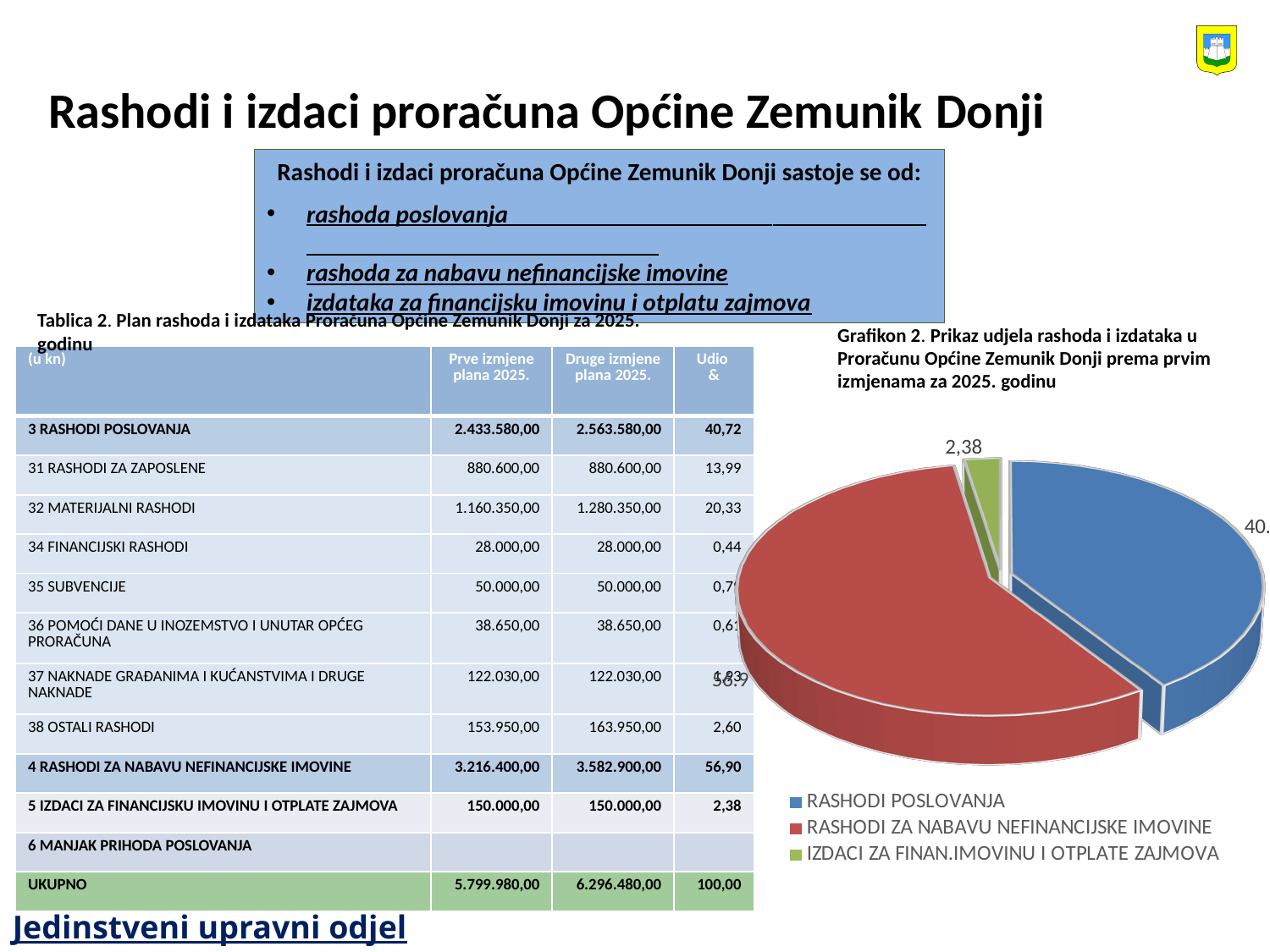
What is the title of the pie chart on the slide? Grafikon 2. Prikaz udjela rashoda i izdataka u Proračunu Općine Zemunik Donji prema prvim izmjenama za 2025. godinu Which category has the largest slice in the pie chart? RASHODI ZA NABAVU NEFINANCIJSKE IMOVINE How many slices does the pie chart have? 3 What share of the pie does the IZDACI ZA FINAN.IMOVINU I OTPLATE ZAJMOVA slice represent, as labelled on the chart? 2,38 In the pie chart, which slice is larger: RASHODI POSLOVANJA or IZDACI ZA FINAN.IMOVINU I OTPLATE ZAJMOVA? RASHODI POSLOVANJA What kind of chart is shown on the slide? pie chart Which category has the smallest slice in the pie chart? IZDACI ZA FINAN.IMOVINU I OTPLATE ZAJMOVA How many entries does the legend of the pie chart list? 3 What colour is the RASHODI POSLOVANJA slice in the pie chart? blue What value is labelled on the pie chart for IZDACI ZA FINAN.IMOVINU I OTPLATE ZAJMOVA? 2,38 In the pie chart, which slice is larger: RASHODI POSLOVANJA or RASHODI ZA NABAVU NEFINANCIJSKE IMOVINE? RASHODI ZA NABAVU NEFINANCIJSKE IMOVINE